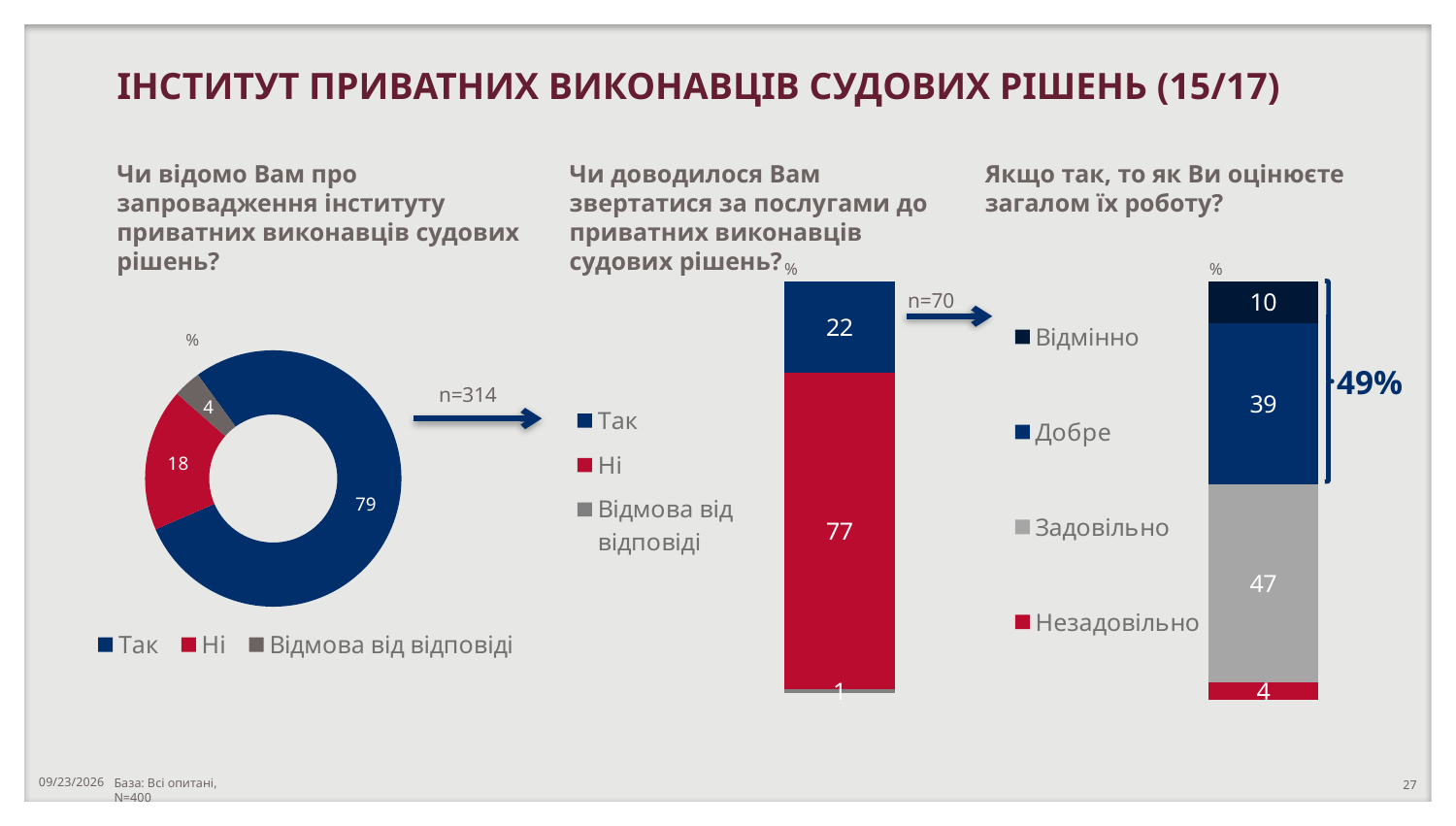
How many categories does the legend of the right stacked bar chart list? 4 What type of chart is the leftmost chart on the slide? Pie (donut) chart In the left donut chart ("Чи відомо Вам про запровадження інституту приватних виконавців судових рішень?"), what is the value for "Так"? 79 In the left donut chart, what is the difference between the values for "Так" and "Ні"? 61 In the middle stacked bar chart, which category has the highest value? Ні In the right stacked bar chart, what is the combined value of "Відмінно" and "Добре"? 49 In the right stacked bar chart ("Якщо так, то як Ви оцінюєте загалом їх роботу?"), what is the value for "Задовільно"? 47 In the right stacked bar chart, which is larger: "Відмінно" or "Добре"? Добре In the middle stacked bar chart ("Чи доводилося Вам звертатися за послугами до приватних виконавців судових рішень?"), what is the value for "Ні"? 77 How many entries does the legend of the middle stacked bar chart list? 3 In the left donut chart, which category has the smallest share? Відмова від відповіді In the middle stacked bar chart, what is the value for "Відмова від відповіді"? 1